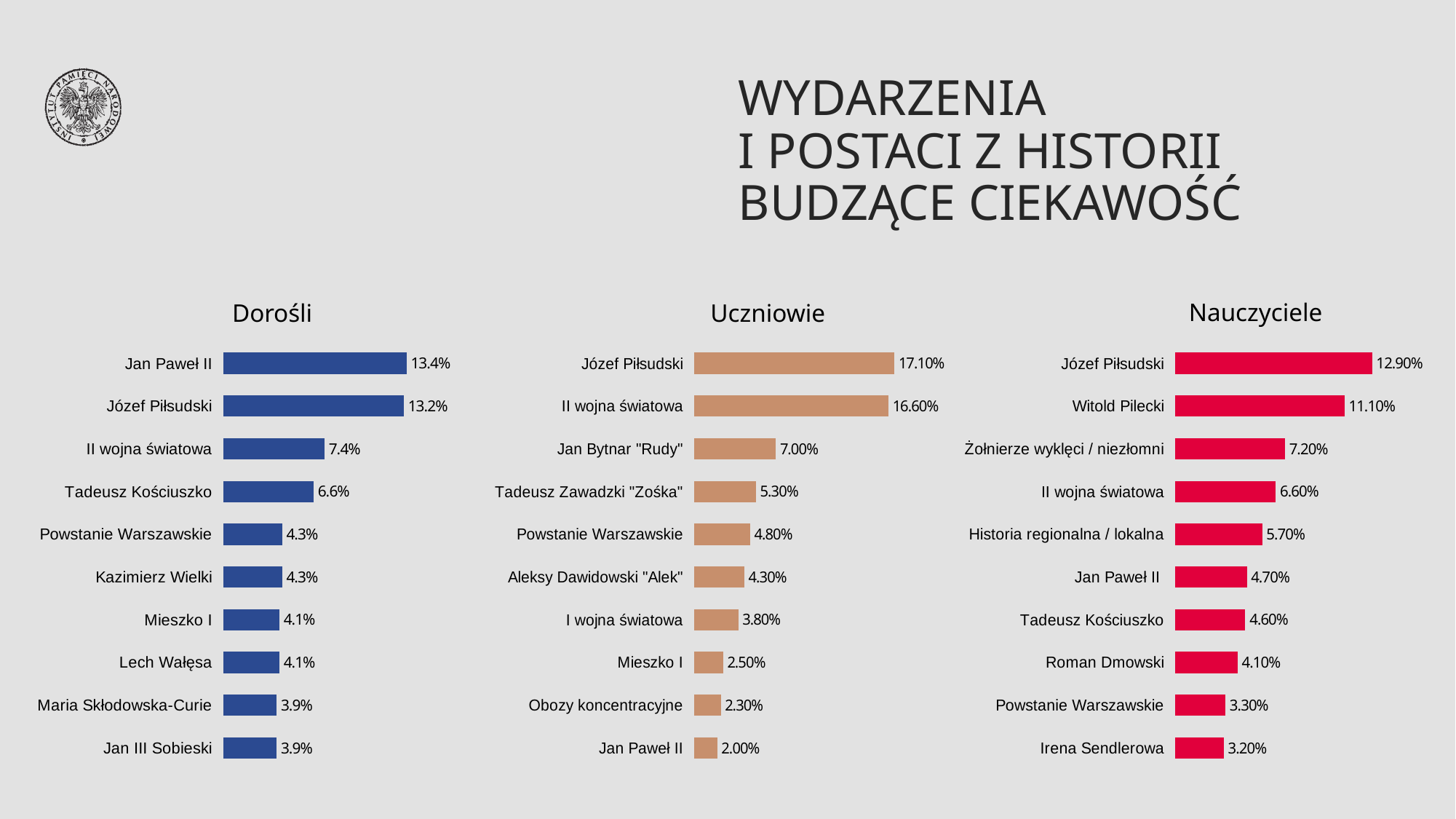
In the "Nauczyciele" chart, what is the value for Witold Pilecki? 11.10% How many charts are shown on the slide? 3 In the "Nauczyciele" chart, which is larger: the value for Jan Paweł II or the value for Roman Dmowski? Jan Paweł II What kind of chart is the "Uczniowie" chart? Bar chart In the "Uczniowie" chart, which category has the highest value? Józef Piłsudski In the "Dorośli" chart, what is the value for Jan Paweł II? 13.4% In the "Dorośli" chart, what is the difference between the values for Jan Paweł II and II wojna światowa? 6.0% What colour are the bars in the "Nauczyciele" chart? Red In the "Uczniowie" chart, what is the difference between the values for Józef Piłsudski and II wojna światowa? 0.50% In the "Uczniowie" chart, what is the value for Jan Bytnar "Rudy"? 7.00% In the "Nauczyciele" chart, which category has the lowest value? Irena Sendlerowa How many categories are shown in the "Dorośli" chart? 10